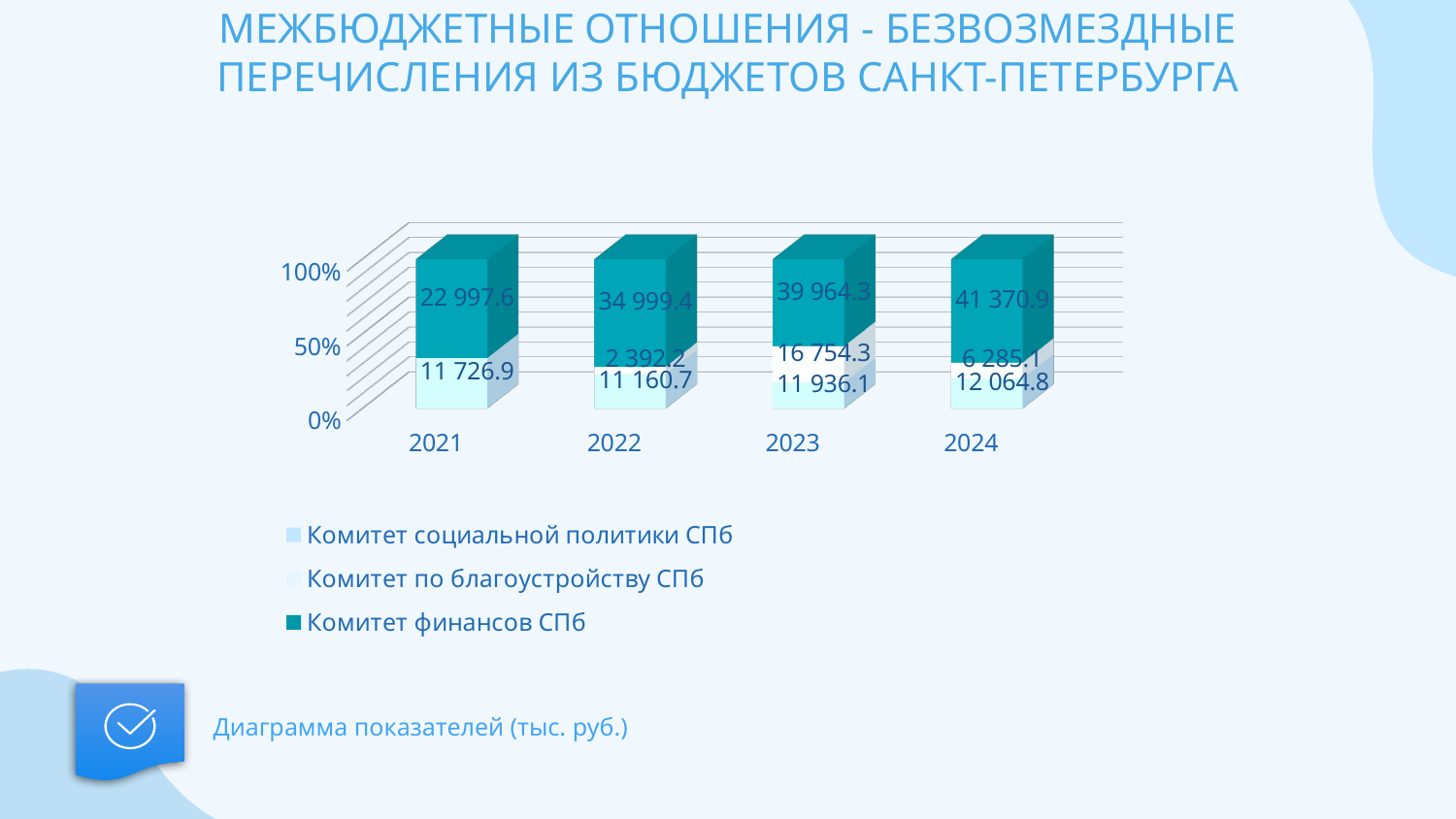
What is the value for Комитет по благоустройству СПб in 2023? 16 754.3 How many series does the legend list? 3 How many years are shown on the x axis? 4 What kind of chart is shown on the slide? Stacked bar chart What is the value for Комитет финансов СПб in 2021? 22 997.6 Do the values for Комитет финансов СПб rise or fall from 2021 to 2024? Rise In which year is the value for Комитет социальной политики СПб the lowest? 2022 What is the value for Комитет социальной политики СПб in 2024? 12 064.8 Which is larger: the Комитет по благоустройству СПб value in 2023 or in 2024? 2023 What is the difference between the Комитет финансов СПб values in 2024 and 2021? 18 373.3 In which year is the value for Комитет финансов СПб the highest? 2024 What is the total of the stacked bar for 2022? 48 552.3